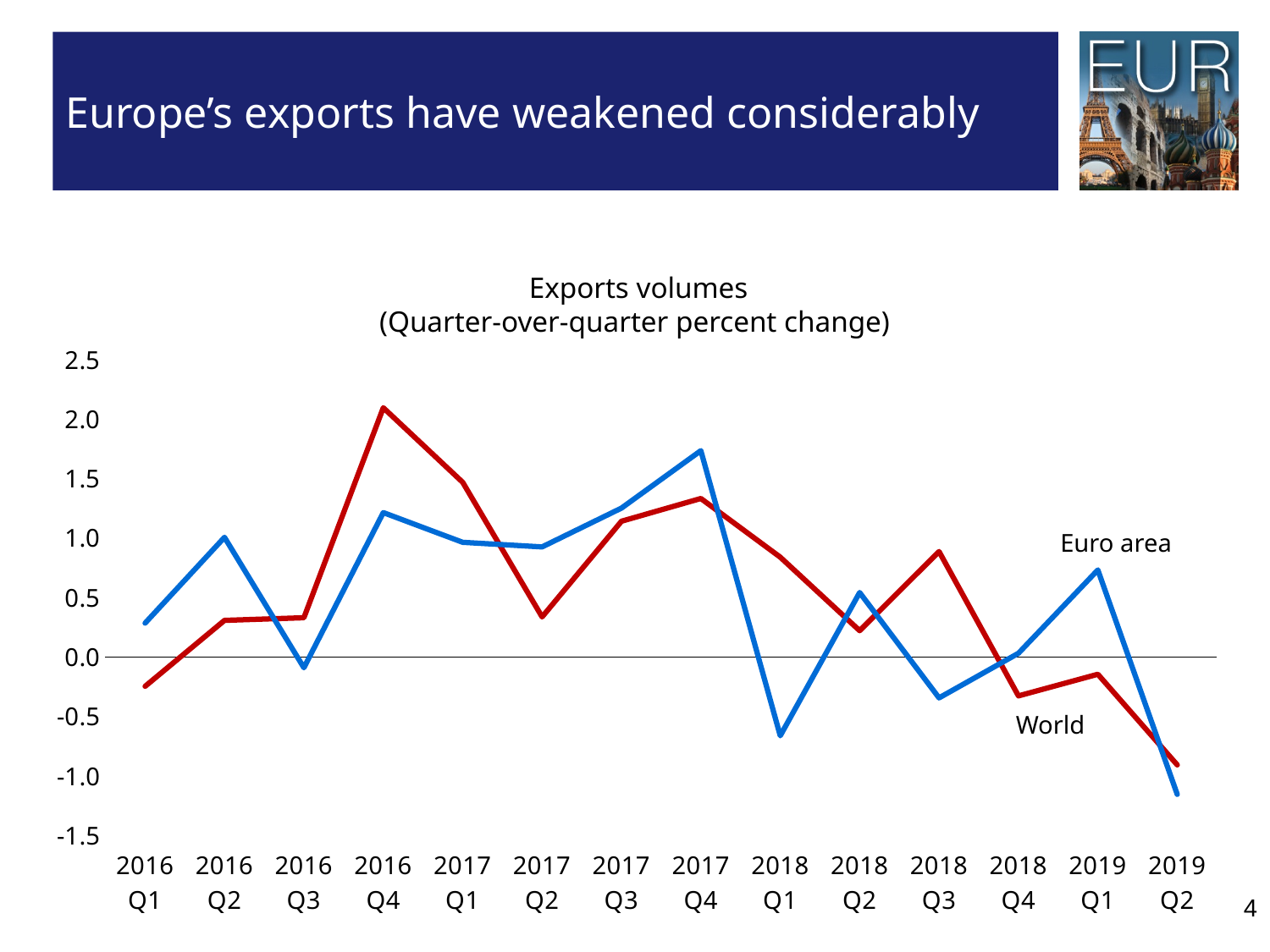
Is the World value for 2016 Q4 greater or less than 1.5? greater In which quarter does the World series reach its highest value? 2016 Q4 What kind of chart is shown on the slide? line chart In 2016 Q4, which series has the larger value, Euro area or World? World How many series are plotted on the chart? 2 How many quarters are shown along the x axis? 14 In which quarter does the World series reach its lowest value? 2019 Q2 Is the Euro area value for 2018 Q1 greater or less than -0.5? less In which quarter does the Euro area series reach its lowest value? 2019 Q2 What is the title of the chart? Exports volumes (Quarter-over-quarter percent change) In 2019 Q1, which series has the larger value, Euro area or World? Euro area In which quarter does the Euro area series reach its highest value? 2017 Q4